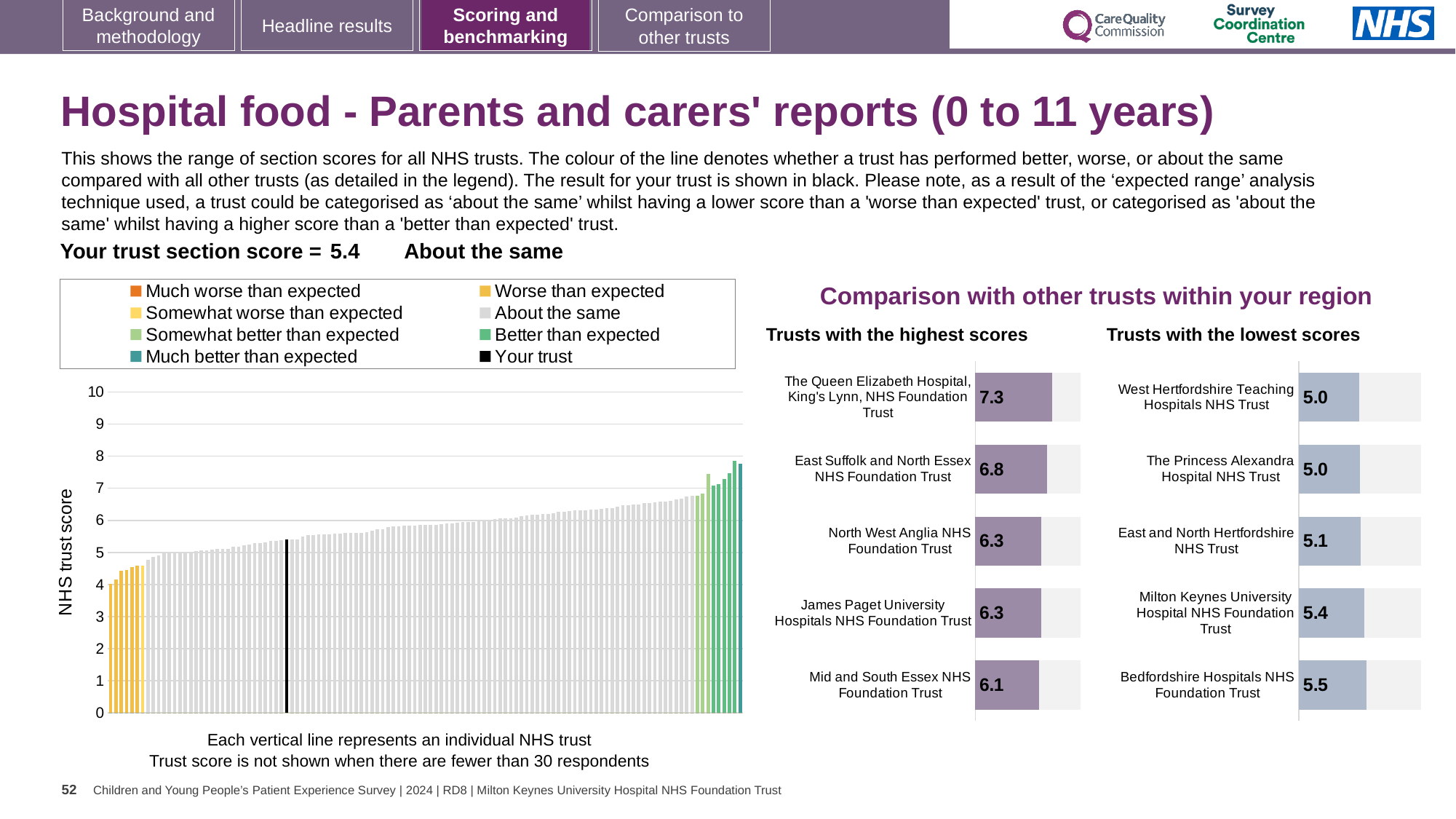
In the 'Trusts with the lowest scores' chart, which trust has the highest score? Bedfordshire Hospitals NHS Foundation Trust What is the section score for your trust shown on the slide? 5.4 How many trusts are shown in the 'Trusts with the lowest scores' chart? 5 In the main 'NHS trust score' chart, is the value of the lowest bar greater or less than 5? less In the 'Trusts with the highest scores' chart, which trust has the highest score? The Queen Elizabeth Hospital, King's Lynn, NHS Foundation Trust What kind of chart is the main 'NHS trust score' chart on the left? Bar chart In the main 'NHS trust score' chart, do the bars rise or fall from left to right? Rise In the 'Trusts with the highest scores' chart, what is the score for The Queen Elizabeth Hospital, King's Lynn, NHS Foundation Trust? 7.3 In the 'Trusts with the lowest scores' chart, what is the score for Bedfordshire Hospitals NHS Foundation Trust? 5.5 How many entries does the legend of the main NHS trust score chart list? 8 In the 'Trusts with the highest scores' chart, which has the higher score: East Suffolk and North Essex NHS Foundation Trust or North West Anglia NHS Foundation Trust? East Suffolk and North Essex NHS Foundation Trust In the 'Trusts with the highest scores' chart, what is the difference between the scores of The Queen Elizabeth Hospital, King's Lynn and Mid and South Essex NHS Foundation Trust? 1.2